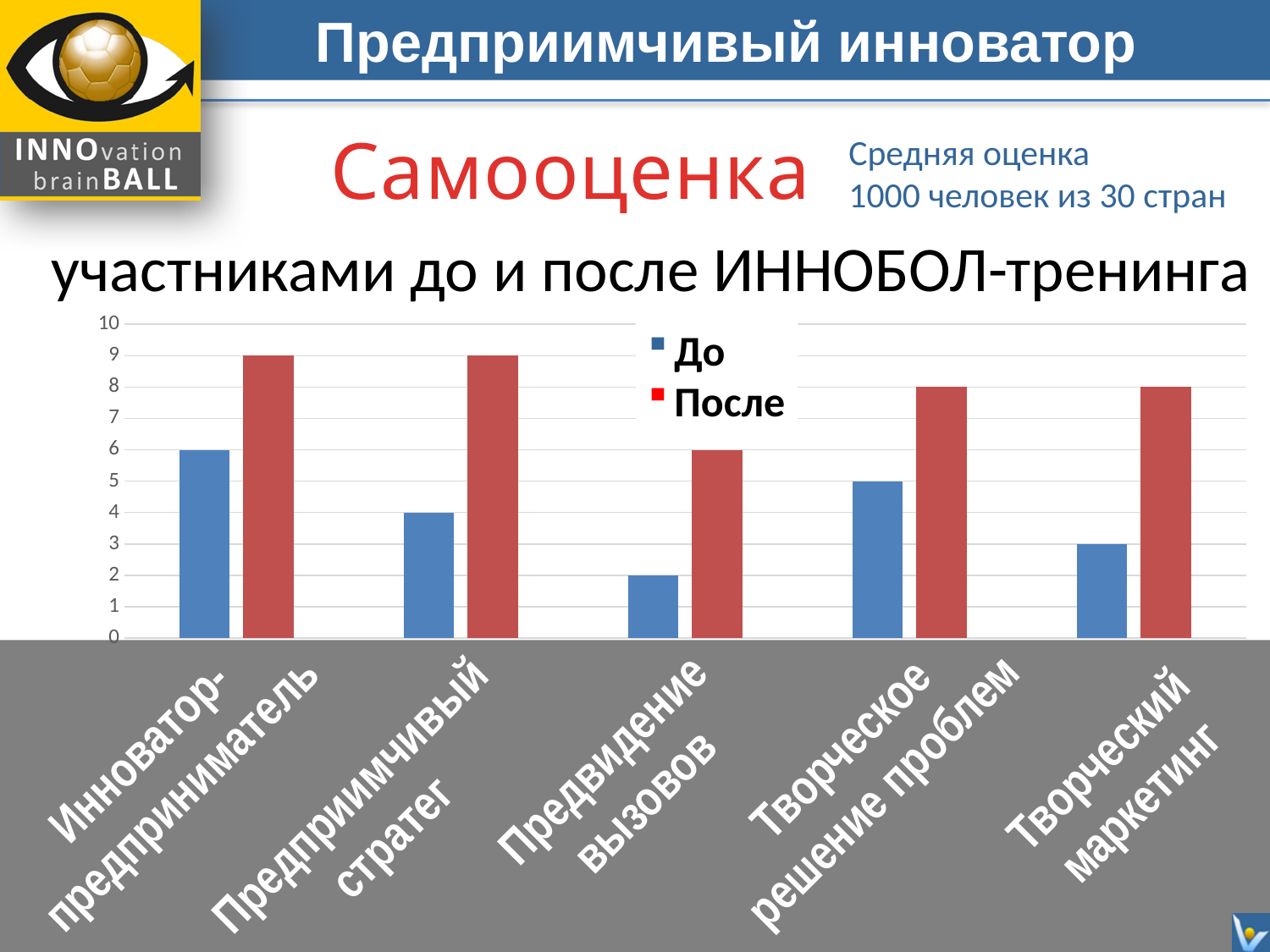
Is the 'После' value for 'Творческое решение проблем' greater or less than 5? greater What is the value of the 'До' series for 'Инноватор-предприниматель'? 6 Which category has the lowest 'До' value? Предвидение вызовов What is the value of the 'После' series for 'Предвидение вызовов'? 6 What kind of chart is shown on the slide? Bar chart What colour are the bars for the 'После' series? Red Which is larger: the 'До' value for 'Творческое решение проблем' or the 'До' value for 'Предприимчивый стратег'? Творческое решение проблем What are the two legend entries of the chart? До, После What is the value of the 'До' series for 'Творческий маркетинг'? 3 What is the difference between the 'После' and 'До' values for 'Предприимчивый стратег'? 5 How many series does the legend list? 2 How many categories are shown on the x axis? 5